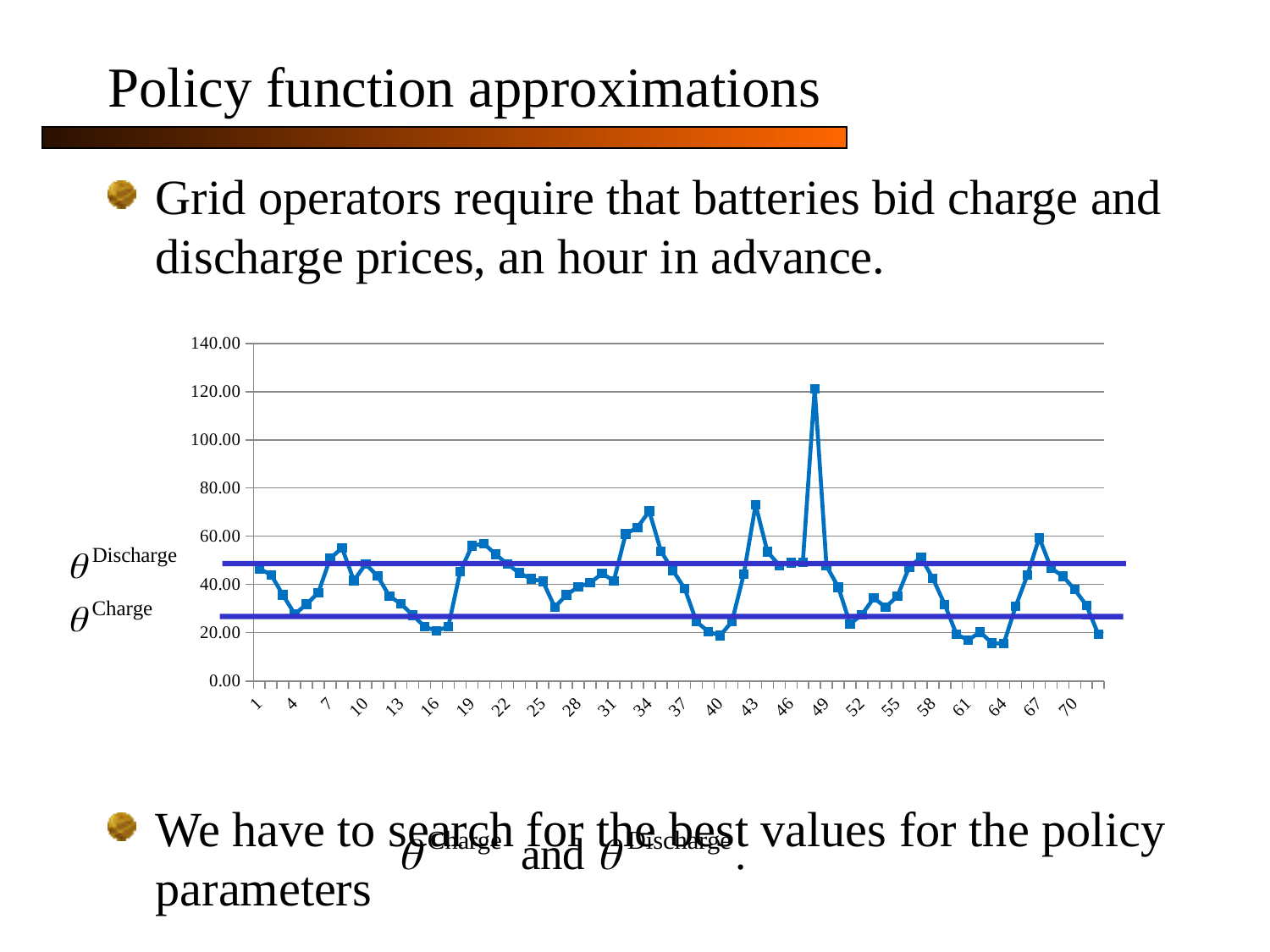
What kind of chart is shown on the slide? line chart Is the highest point of the line greater or less than 100? greater Is the value at x = 34 greater or less than 60? greater What is the highest value shown on the y axis of the chart? 140.00 Do the values rise or fall from x = 40 to x = 43? rise Is the value at x = 1 greater or less than 40? greater Do the values rise or fall from x = 1 to x = 4? fall Which of the two horizontal lines on the chart is higher, the one labelled θ Discharge or the one labelled θ Charge? θ Discharge What is the lowest value shown on the y axis of the chart? 0.00